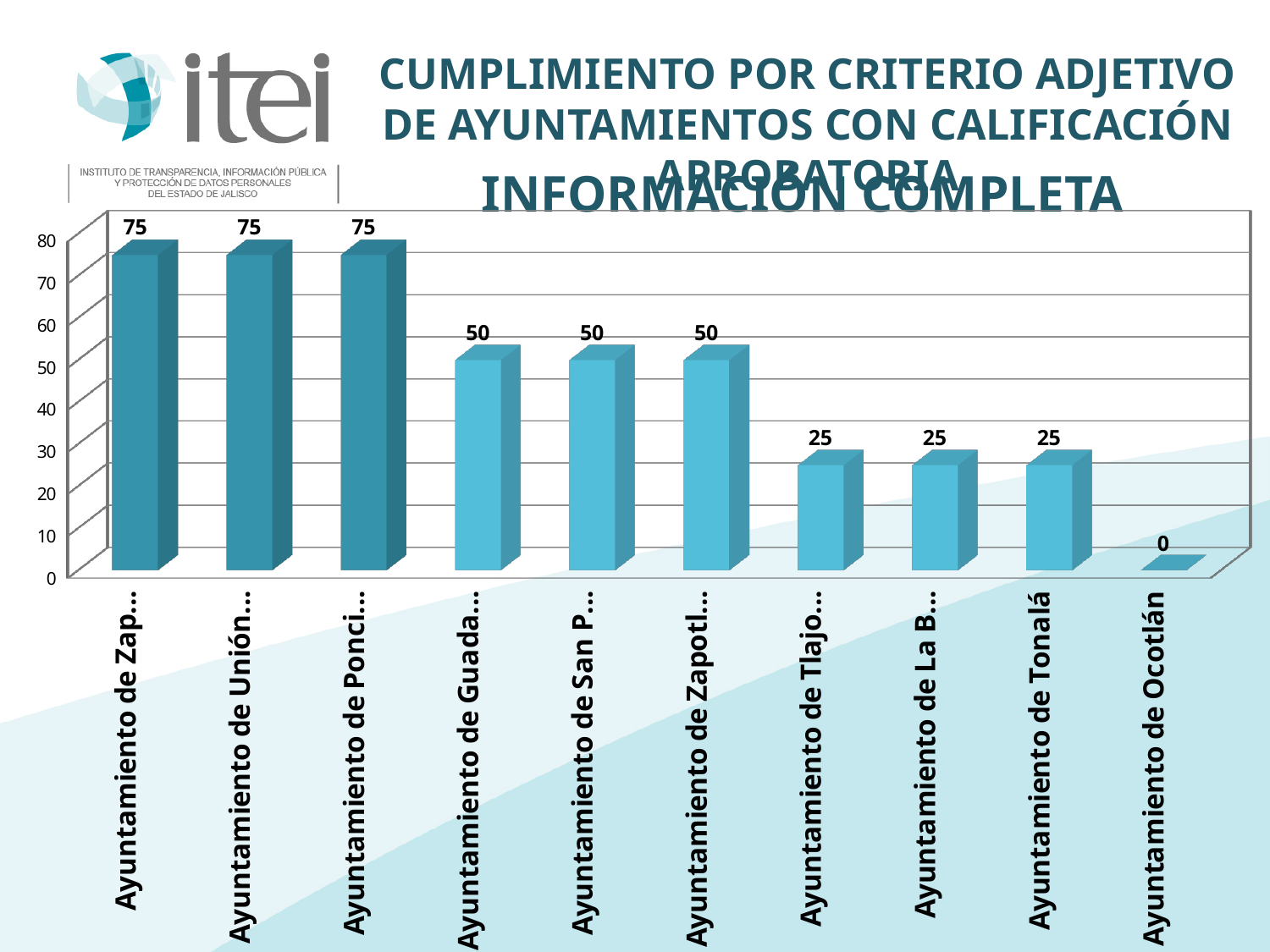
How many bars (categories) does the chart show? 10 What is the difference between the value for Ayuntamiento de Tonalá and the value for Ayuntamiento de Ocotlán? 25 What is the difference between the first bar from the left and the fourth bar from the left? 25 What is the highest value shown on the vertical axis? 80 What is the value for Ayuntamiento de Ocotlán? 0 Do the values rise or fall moving from left to right along the x axis? fall Which is larger, the value for Ayuntamiento de Tonalá or the value for Ayuntamiento de Ocotlán? Ayuntamiento de Tonalá What is the value for Ayuntamiento de Tonalá? 25 What is the value of the fourth bar from the left? 50 What kind of chart is shown on the slide? bar chart Which category has the lowest value? Ayuntamiento de Ocotlán What is the value of the first bar from the left? 75